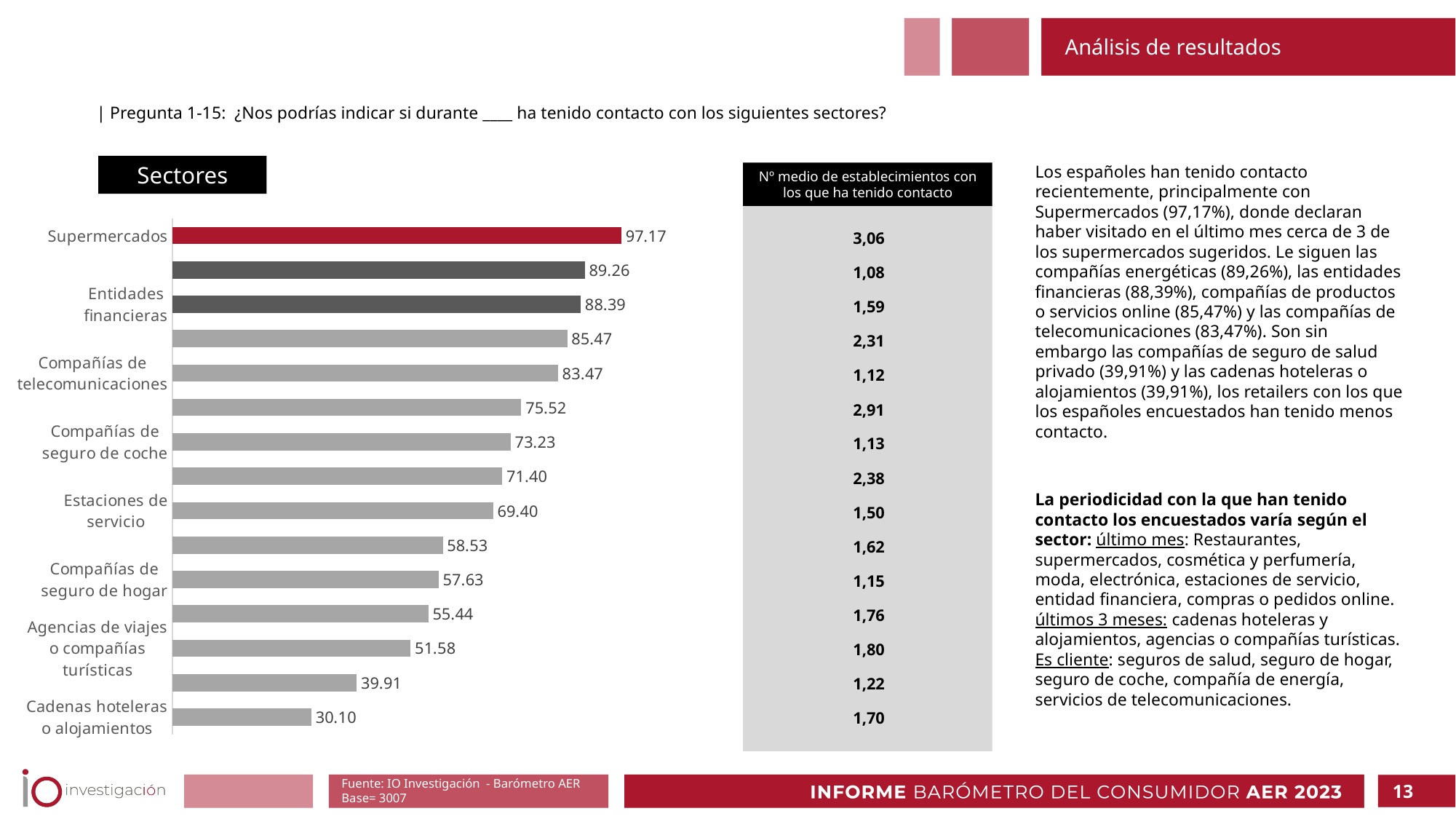
How many bars are plotted in the chart? 15 What is the value for Compañías de telecomunicaciones? 83.47 What kind of chart is shown on the slide? Bar chart What is the value for Supermercados? 97.17 Which is larger, the value for Entidades financieras or for Compañías de telecomunicaciones? Entidades financieras Which sector has the lowest value in the chart? Cadenas hoteleras o alojamientos What is the value for Compañías de seguro de coche? 73.23 What is the value for Entidades financieras? 88.39 What is the value for Estaciones de servicio? 69.40 Which sector has the highest value in the chart? Supermercados What is the difference between the values for Supermercados and Entidades financieras? 8.78 What is the value for Cadenas hoteleras o alojamientos? 30.10